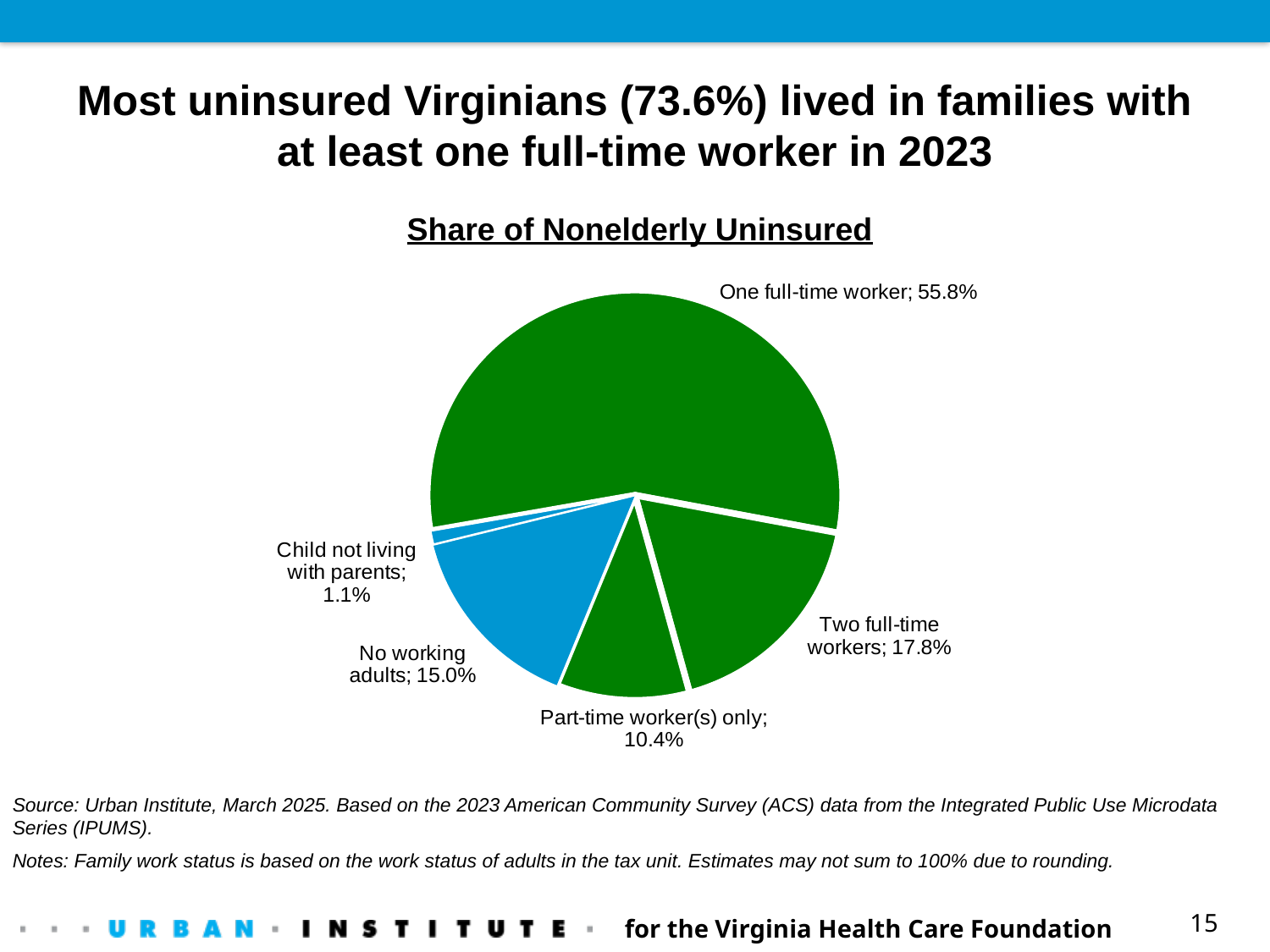
What is the difference between the share for one full-time worker and the share for two full-time workers? 38.0 percentage points How many slices does the pie chart have? 5 What kind of chart is shown on the slide? Pie chart Which category has the largest share of the pie? One full-time worker What share of nonelderly uninsured lived in families with one full-time worker? 55.8% What share of nonelderly uninsured were children not living with parents? 1.1% What is the title of the chart? Share of Nonelderly Uninsured What share of nonelderly uninsured lived in families with part-time worker(s) only? 10.4% Which is larger: the share for no working adults or the share for part-time worker(s) only? No working adults Which category has the smallest share of the pie? Child not living with parents What share of nonelderly uninsured lived in families with two full-time workers? 17.8% What share of nonelderly uninsured lived in families with no working adults? 15.0%